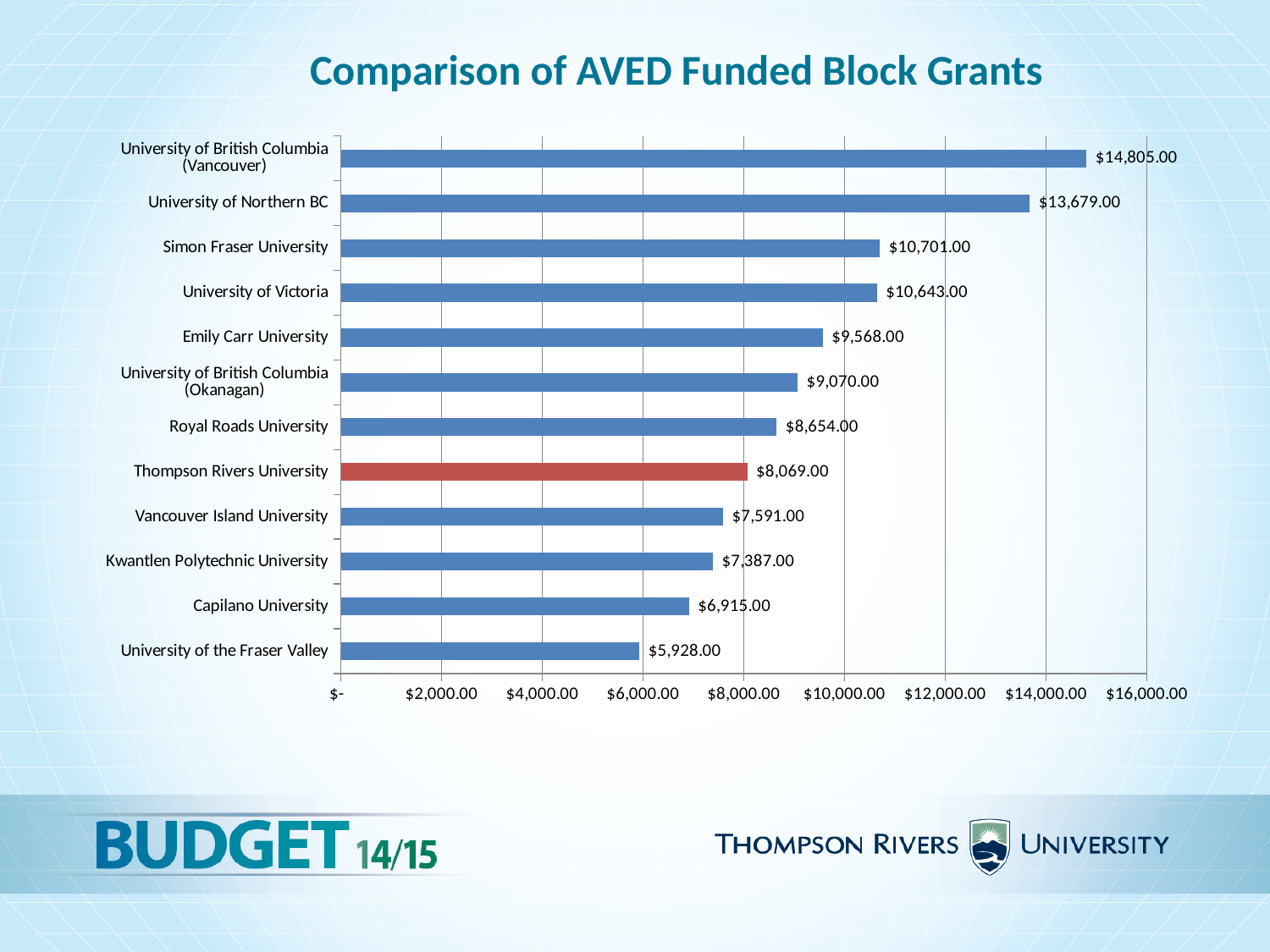
Which university has the highest block grant value? University of British Columbia (Vancouver) What is the value shown for Simon Fraser University? $10,701.00 What is the AVED funded block grant value for Thompson Rivers University? $8,069.00 What is the difference between the values for University of British Columbia (Vancouver) and University of Northern BC? $1,126.00 Which has a larger value, Emily Carr University or University of British Columbia (Okanagan)? Emily Carr University Which university's bar is coloured red instead of blue? Thompson Rivers University What is the difference between the values for Royal Roads University and Thompson Rivers University? $585.00 Which university has the lowest block grant value? University of the Fraser Valley How many universities are shown in the chart? 12 What kind of chart is shown on the slide? bar chart Is the value for Capilano University greater or less than $8,000.00? less What is the value shown for University of the Fraser Valley? $5,928.00